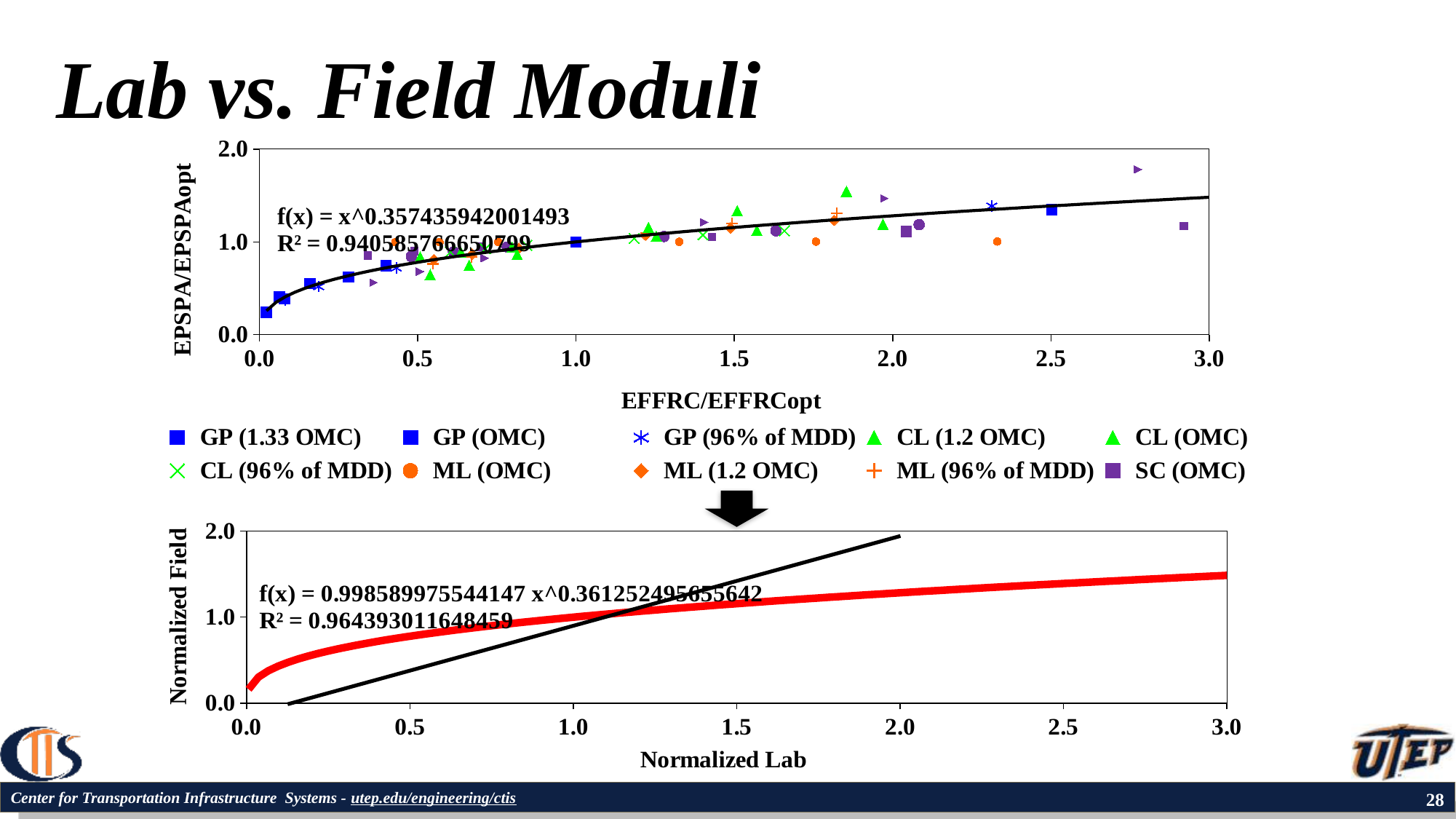
What exponent appears in the fitted equation f(x) on the top chart? 0.357435942001493 What coefficient multiplies x in the fitted equation on the bottom chart? 0.998589975544147 What is the y-axis title of the bottom chart? Normalized Field What kind of chart is the top chart on the slide? scatter chart How many series does the legend of the top chart list? 10 What R² value is printed on the bottom chart? 0.964393011648459 In the top chart, is the highest SC (OMC) point greater or less than 1.5 on the y axis? less In the top chart, does the fitted curve rise or fall as EFFRC/EFFRCopt increases? rise How many charts are shown on the slide? 2 In the bottom chart, is the value of the red curve at Normalized Lab = 3.0 greater or less than 1.0? greater What R² value is printed on the top chart? 0.940585766650799 What is the x-axis title of the top chart? EFFRC/EFFRCopt